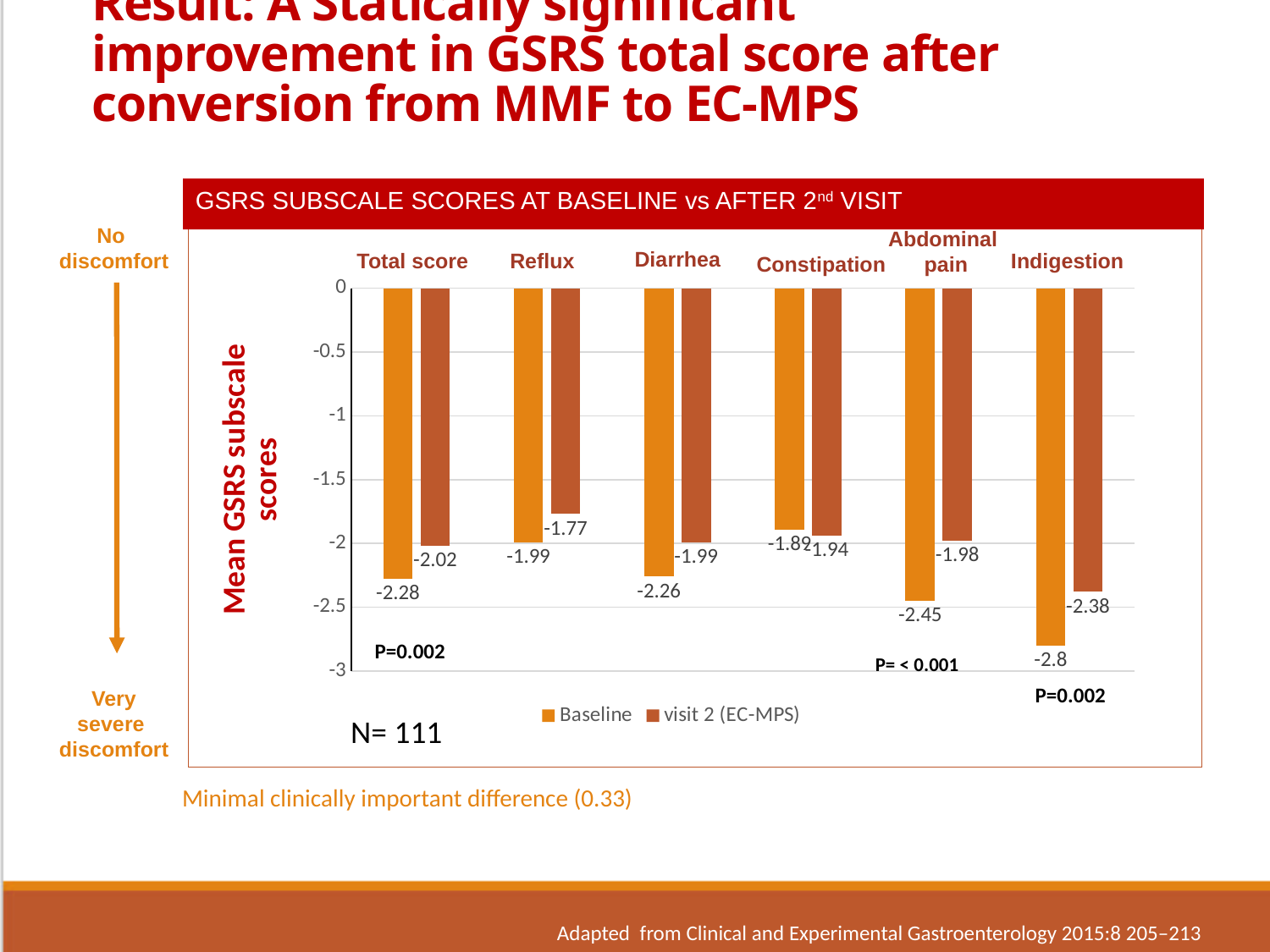
How many series does the legend list? 2 What is the difference between the Baseline and visit 2 (EC-MPS) values for Total score? 0.26 Which category has the highest (least negative) visit 2 (EC-MPS) value? Reflux What is the Baseline value for Indigestion? -2.8 What is the difference between the Baseline and visit 2 (EC-MPS) values for Abdominal pain? 0.47 Which is more negative: the Baseline value for Diarrhea or the Baseline value for Abdominal pain? Abdominal pain What is the visit 2 (EC-MPS) value for Abdominal pain? -1.98 Which category has the lowest (most negative) Baseline value? Indigestion What is the Baseline value for Total score? -2.28 How many categories are shown on the x axis of the chart? 6 What is the visit 2 (EC-MPS) value for Reflux? -1.77 What type of chart is shown on the slide? Bar chart